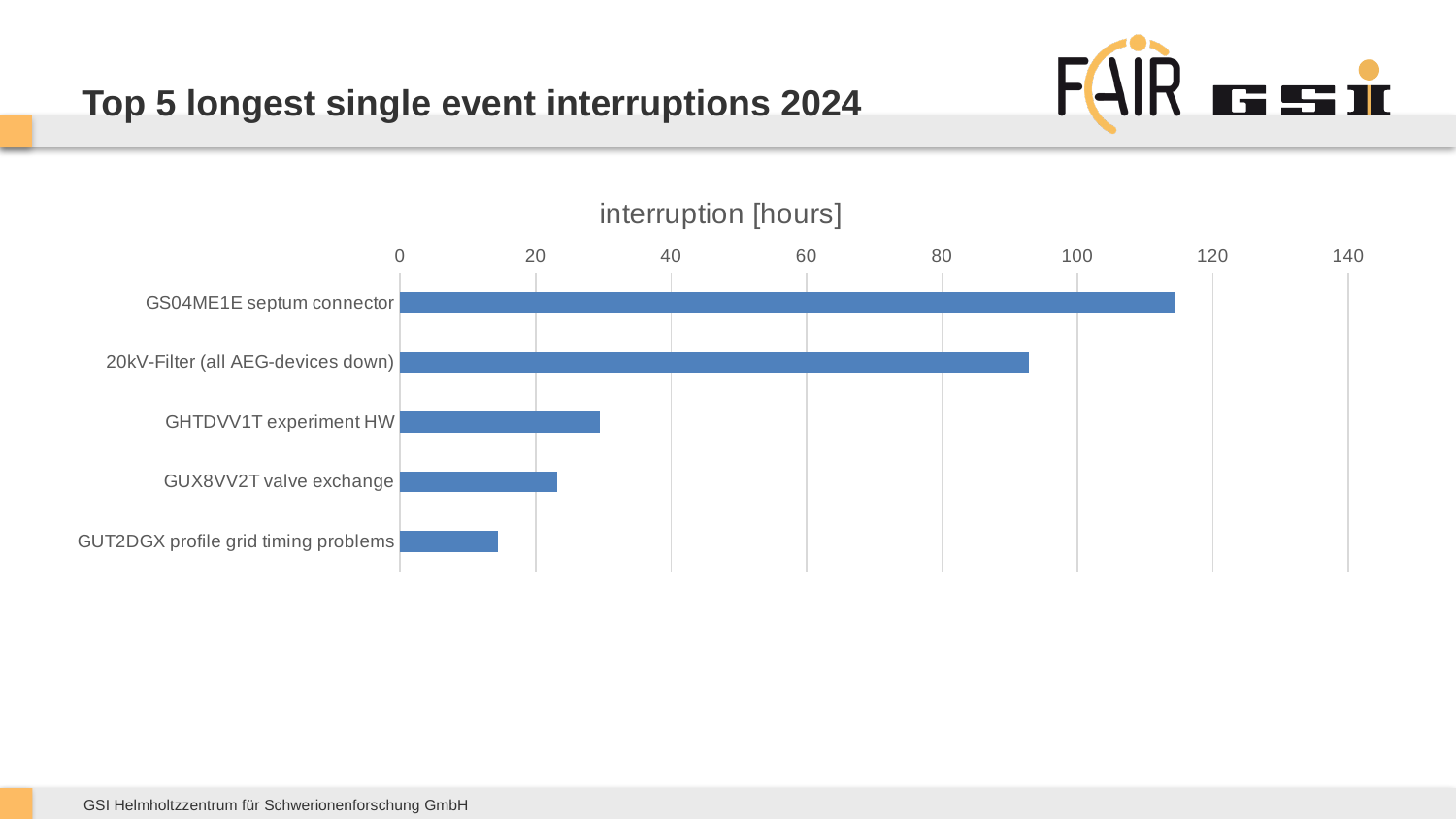
What is the highest tick value shown on the horizontal axis? 140 What is the title of the chart? interruption [hours] Is the value for 20kV-Filter (all AEG-devices down) greater or less than 100? less Is the value for GHTDVV1T experiment HW greater or less than 20? greater How many categories are plotted in the chart? 5 Is the value for GS04ME1E septum connector greater or less than 100? greater What kind of chart is shown on the slide? bar chart Which is larger, the value for 20kV-Filter (all AEG-devices down) or the value for GS04ME1E septum connector? GS04ME1E septum connector Which category has the shortest interruption? GUT2DGX profile grid timing problems Which is larger, the value for GUX8VV2T valve exchange or the value for GHTDVV1T experiment HW? GHTDVV1T experiment HW Which category has the longest interruption? GS04ME1E septum connector